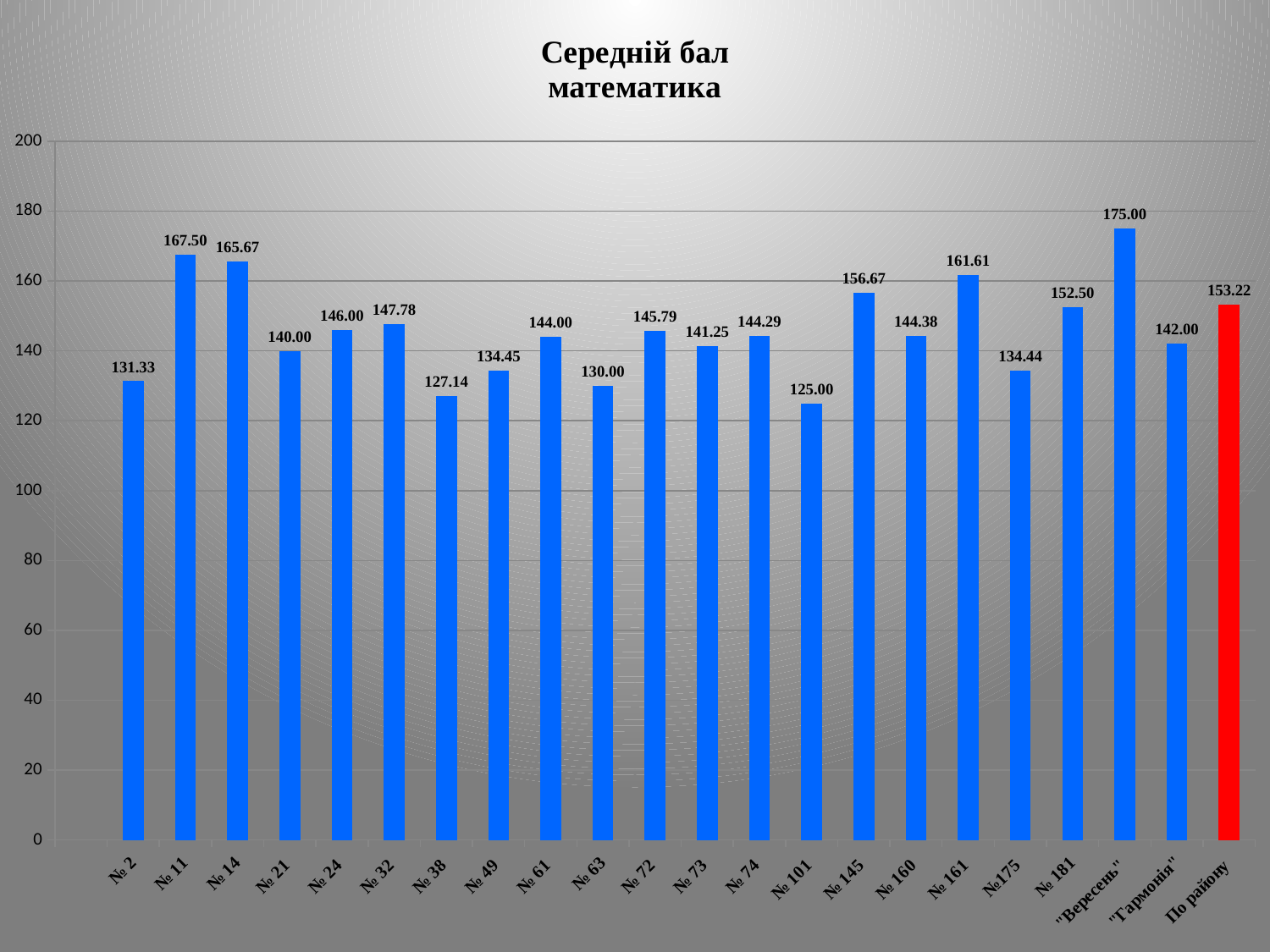
Which category has the lowest value? № 101 What is the difference between the values for № 11 and № 14? 1.83 What is the difference between the values for "Вересень" and № 101? 50.00 Which category is shown with a red bar? По району How many bars are shown in the chart? 22 What is the value for № 11? 167.50 Which is larger, the value for № 145 or the value for № 161? № 161 What is the value for "Гармонія"? 142.00 Is the value for № 38 greater or less than 140? less What is the value for По району? 153.22 What kind of chart is shown on the slide? bar chart Which category has the highest value? "Вересень"